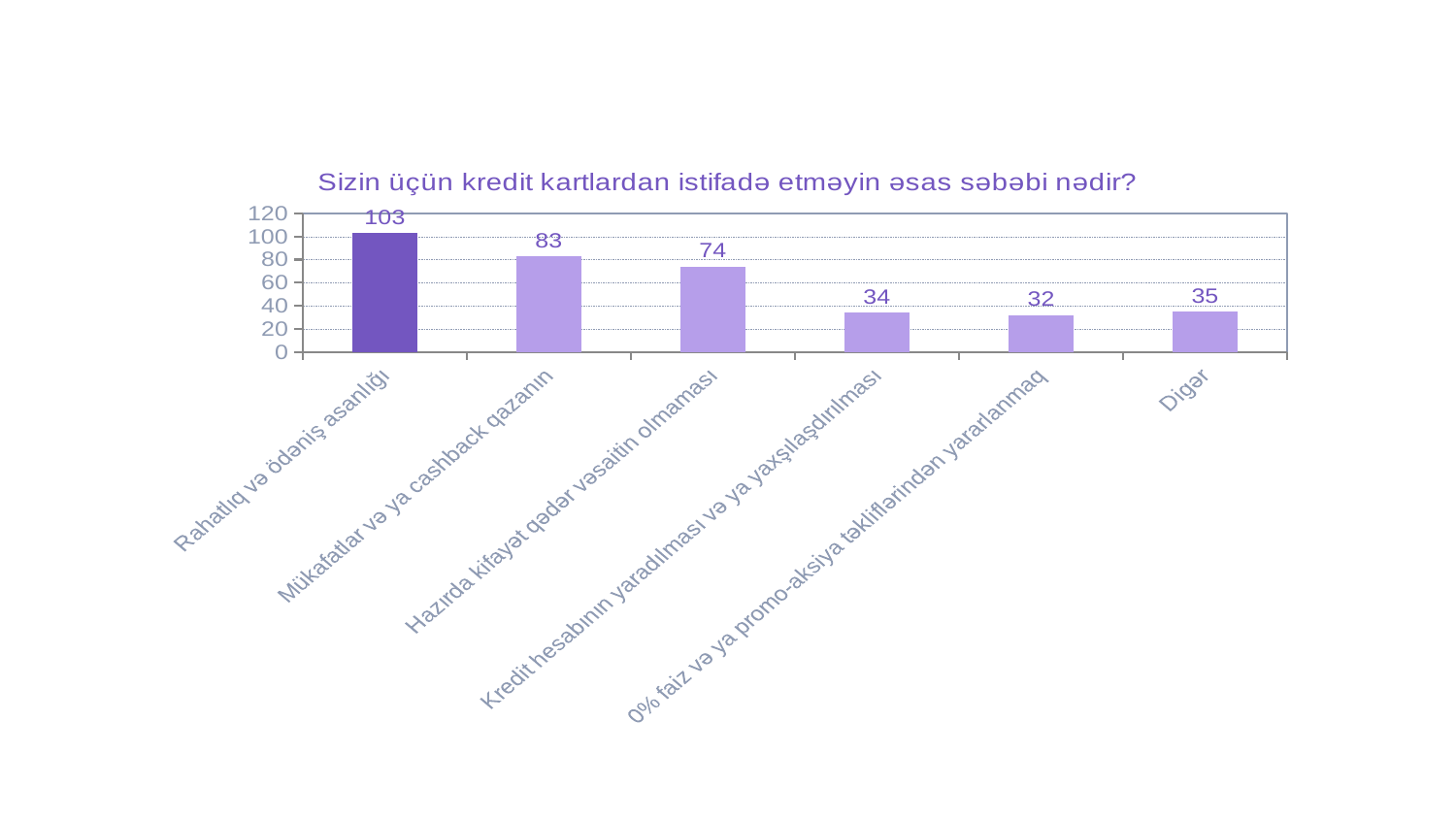
What is the difference between the values for "Rahatlıq və ödəniş asanlığı" and "Mükafatlar və ya cashback qazanın"? 20 What is the value for "Mükafatlar və ya cashback qazanın"? 83 Which category has the lowest value? 0% faiz və ya promo-aksiya təkliflərindən yararlanmaq What is the value for "Rahatlıq və ödəniş asanlığı"? 103 What is the value for "Hazırda kifayət qədər vəsaitin olmaması"? 74 How many categories are shown in the chart? 6 What is the value for "Digər"? 35 Which category has the highest value? Rahatlıq və ödəniş asanlığı Is the value for "Rahatlıq və ödəniş asanlığı" greater or less than 100? greater Which is larger, the value for "Mükafatlar və ya cashback qazanın" or the value for "Hazırda kifayət qədər vəsaitin olmaması"? Mükafatlar və ya cashback qazanın What kind of chart is shown on the slide? bar chart What is the difference between the values for "Hazırda kifayət qədər vəsaitin olmaması" and "Kredit hesabının yaradılması və ya yaxşılaşdırılması"? 40